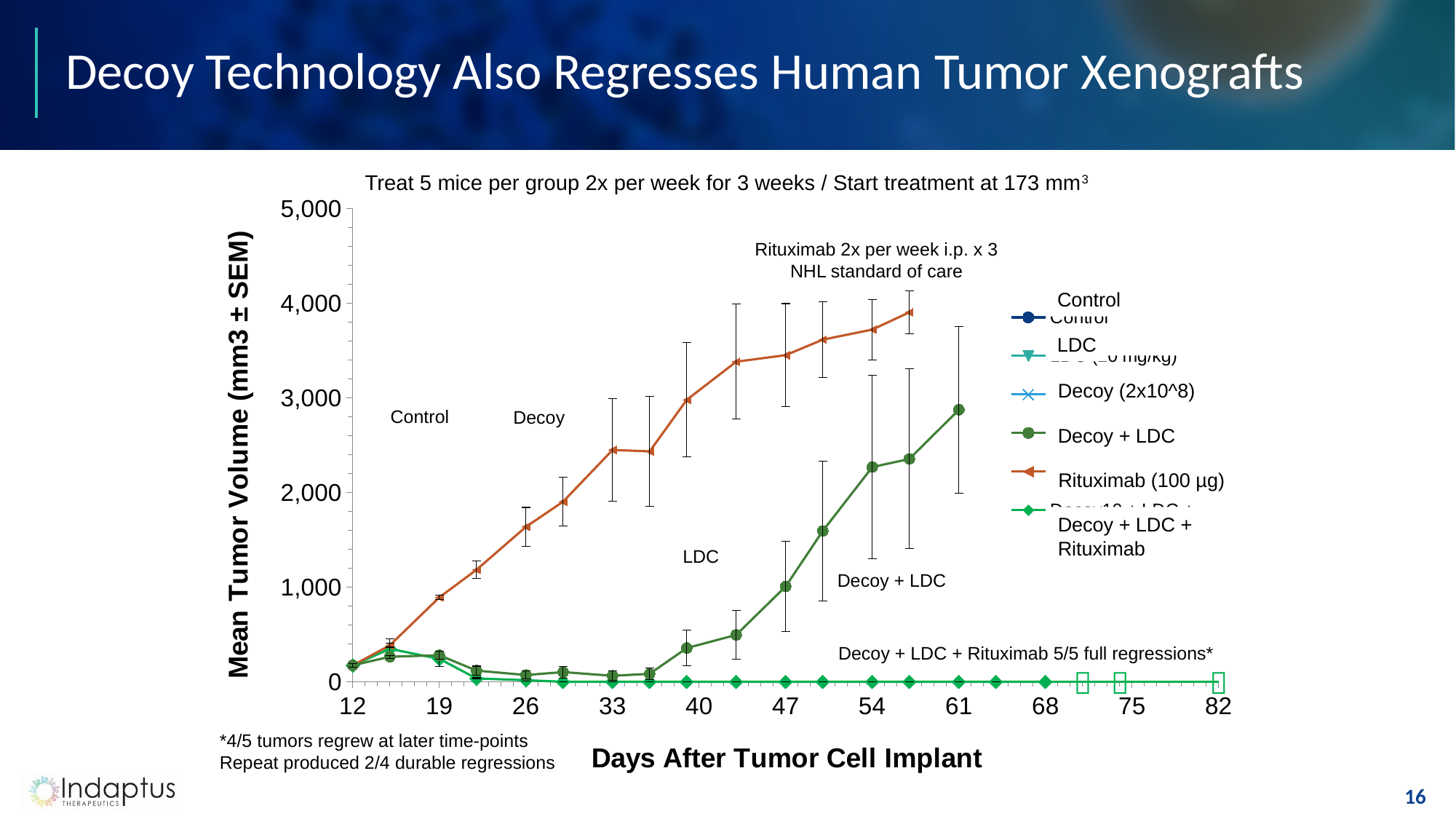
Is the value for Rituximab (100 µg) at day 33 greater or less than 2,000? greater Which series has the lowest mean tumor volume at day 61? Decoy + LDC + Rituximab What kind of chart is shown on the slide? Line chart Is the value for Decoy + LDC + Rituximab at day 68 greater or less than 1,000? less At day 54, which series has the larger mean tumor volume: Rituximab (100 µg) or Decoy + LDC? Rituximab (100 µg) What is the label of the y axis of the chart? Mean Tumor Volume (mm3 ± SEM) How many series does the chart's legend list? 6 Is the final value of the Rituximab (100 µg) series greater or less than 3,000? greater Which series reaches the highest mean tumor volume on the chart? Rituximab (100 µg) What is the label of the x axis of the chart? Days After Tumor Cell Implant Does the Rituximab (100 µg) series rise or fall as days after tumor cell implant increase? Rise